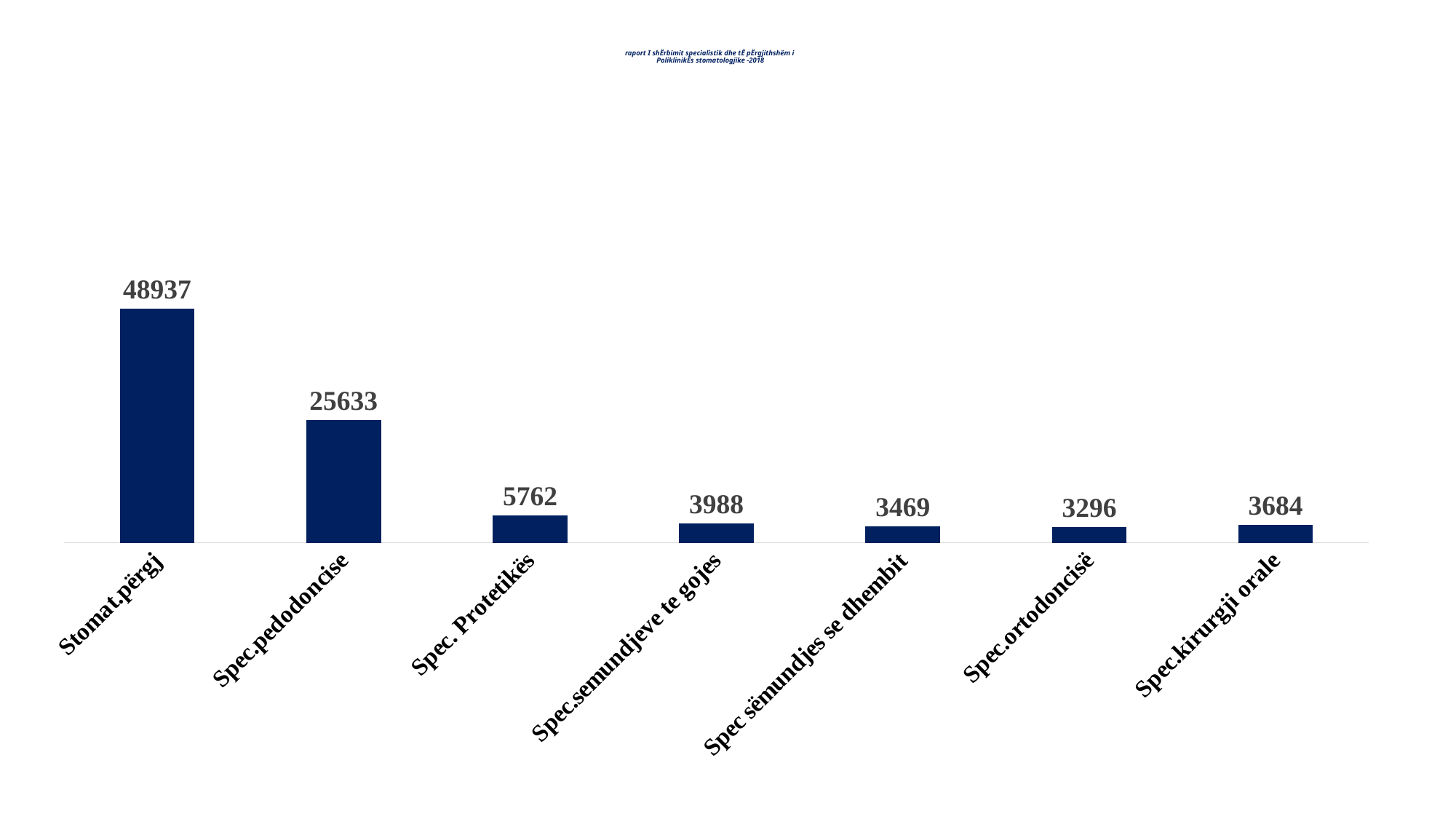
What is the value for Spec. Protetikës? 5762 Which is larger, the value for Spec.kirurgji orale or the value for Spec.ortodoncisë? Spec.kirurgji orale What is the difference between the values for Spec.semundjeve te gojes and Spec sëmundjes se dhembit? 519 How many categories are shown in the chart? 7 Which category has the highest value? Stomat.përgj What is the value for Spec.pedodoncise? 25633 What colour are the bars in the chart? dark blue What is the difference between the values for Stomat.përgj and Spec.pedodoncise? 23304 Which category has the lowest value? Spec.ortodoncisë What is the value for Spec.kirurgji orale? 3684 What is the value for Stomat.përgj? 48937 What kind of chart is shown on the slide? bar chart